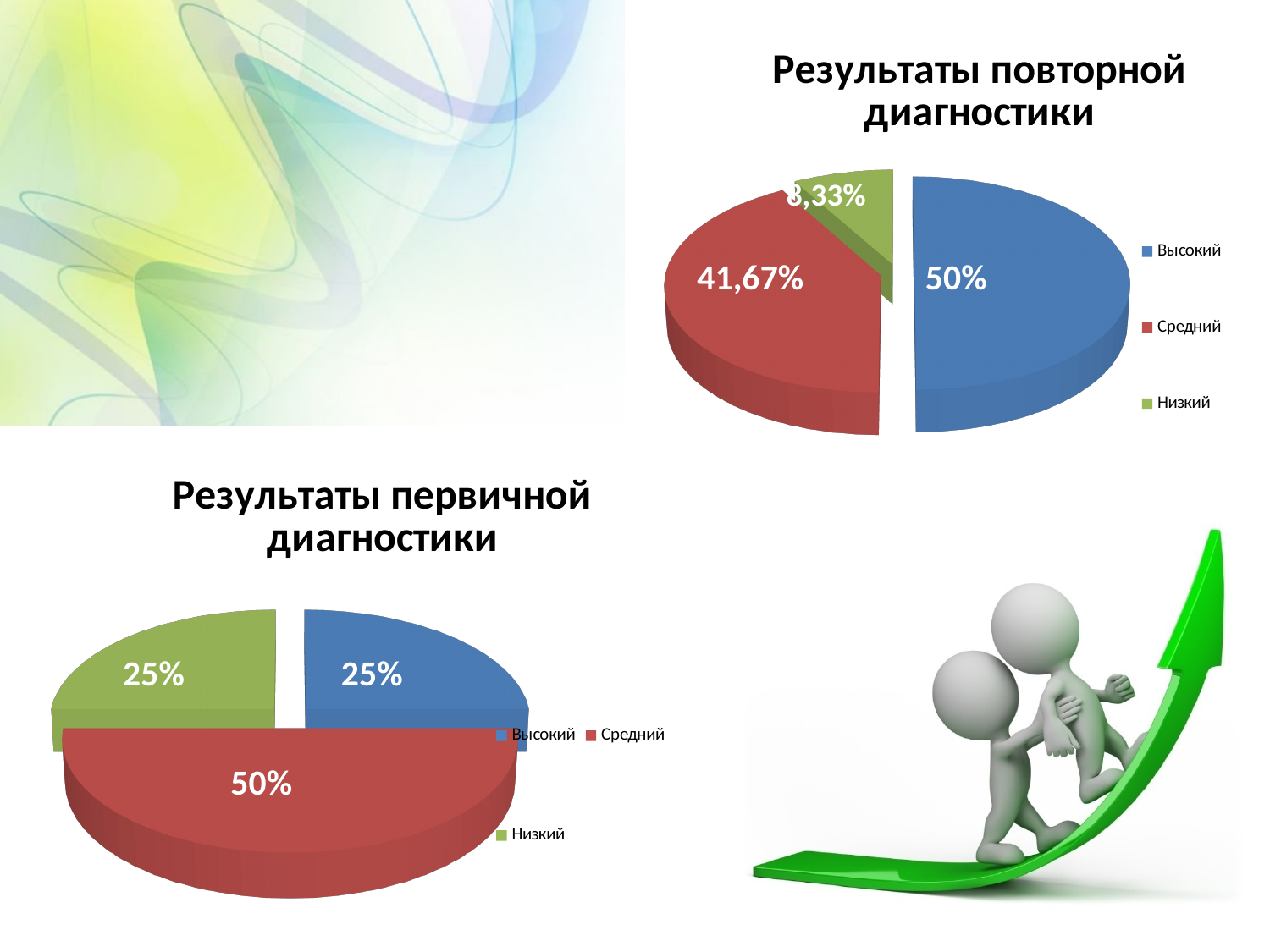
In the chart 'Результаты повторной диагностики', what is the value for Низкий? 8,33% In the chart 'Результаты повторной диагностики', which category has the smallest share? Низкий In the chart 'Результаты повторной диагностики', which is larger, the value for Средний or the value for Низкий? Средний In the chart 'Результаты повторной диагностики', which category has the largest share? Высокий In the chart 'Результаты первичной диагностики', what is the value for Высокий? 25% In the chart 'Результаты повторной диагностики', what is the value for Высокий? 50% In the chart 'Результаты первичной диагностики', what is the difference between the values for Средний and Низкий? 25% In the chart 'Результаты первичной диагностики', what is the value for Средний? 50% In the chart 'Результаты повторной диагностики', what is the value for Средний? 41,67% What kind of chart is 'Результаты повторной диагностики'? Pie chart In the chart 'Результаты первичной диагностики', which category has the largest share? Средний How many categories does the chart 'Результаты первичной диагностики' show? 3